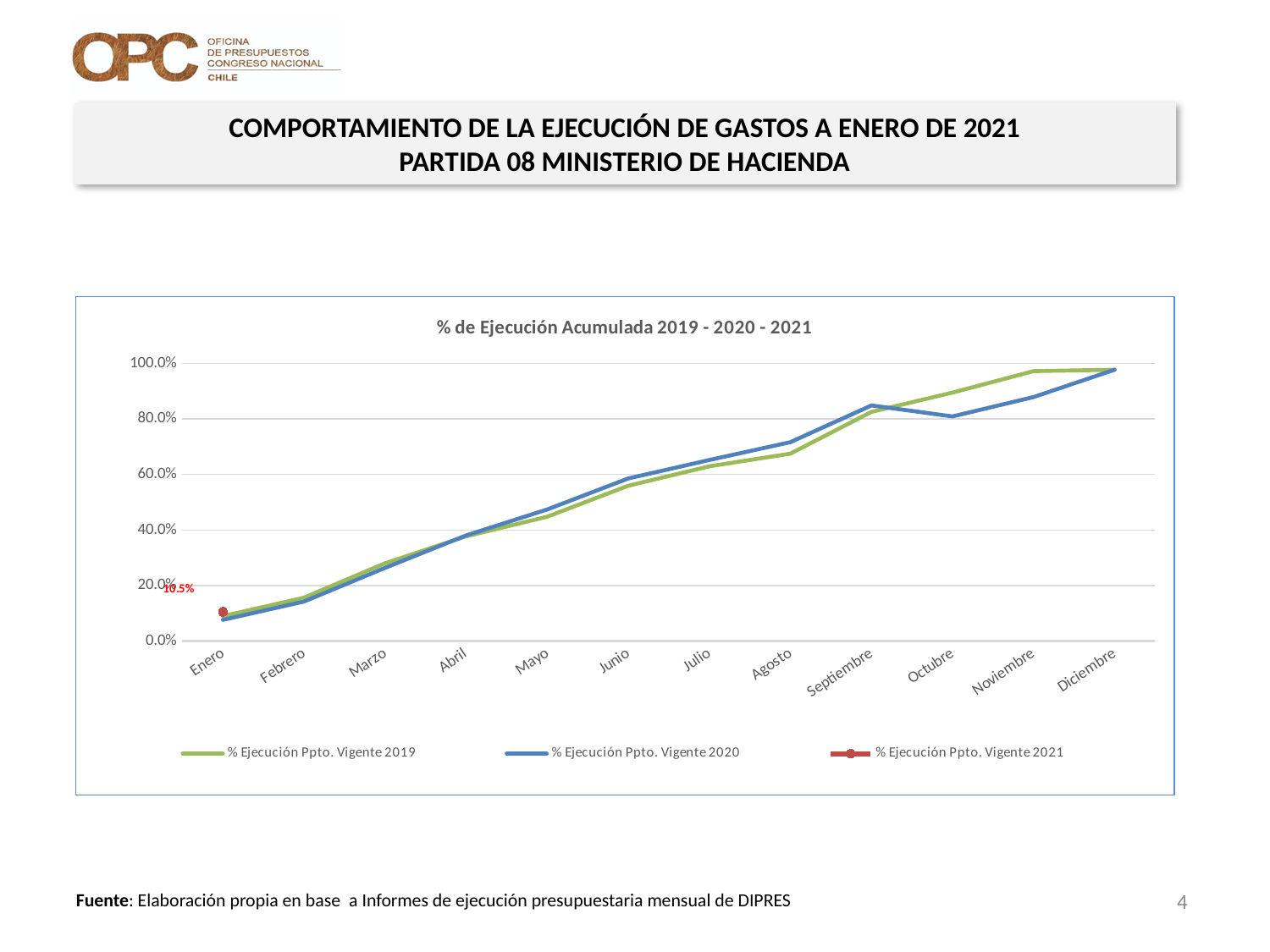
What is the value of % Ejecución Ppto. Vigente 2021 for Enero? 10.5% What kind of chart is shown on the slide? line chart How many series does the chart legend list? 3 What is the title of the chart? % de Ejecución Acumulada 2019 - 2020 - 2021 Does the % Ejecución Ppto. Vigente 2019 series generally rise or fall from Enero to Diciembre? rise In which month is % Ejecución Ppto. Vigente 2019 at its lowest value? Enero In Noviembre, which series has the higher value: % Ejecución Ppto. Vigente 2019 or % Ejecución Ppto. Vigente 2020? % Ejecución Ppto. Vigente 2019 How many months are shown along the x axis of the chart? 12 Is the value of % Ejecución Ppto. Vigente 2019 for Octubre greater or less than 80.0%? greater In which month does % Ejecución Ppto. Vigente 2020 reach its highest value? Diciembre Is the value of % Ejecución Ppto. Vigente 2020 for Agosto greater or less than 80.0%? less Is the value of % Ejecución Ppto. Vigente 2020 for Marzo greater or less than 20.0%? greater